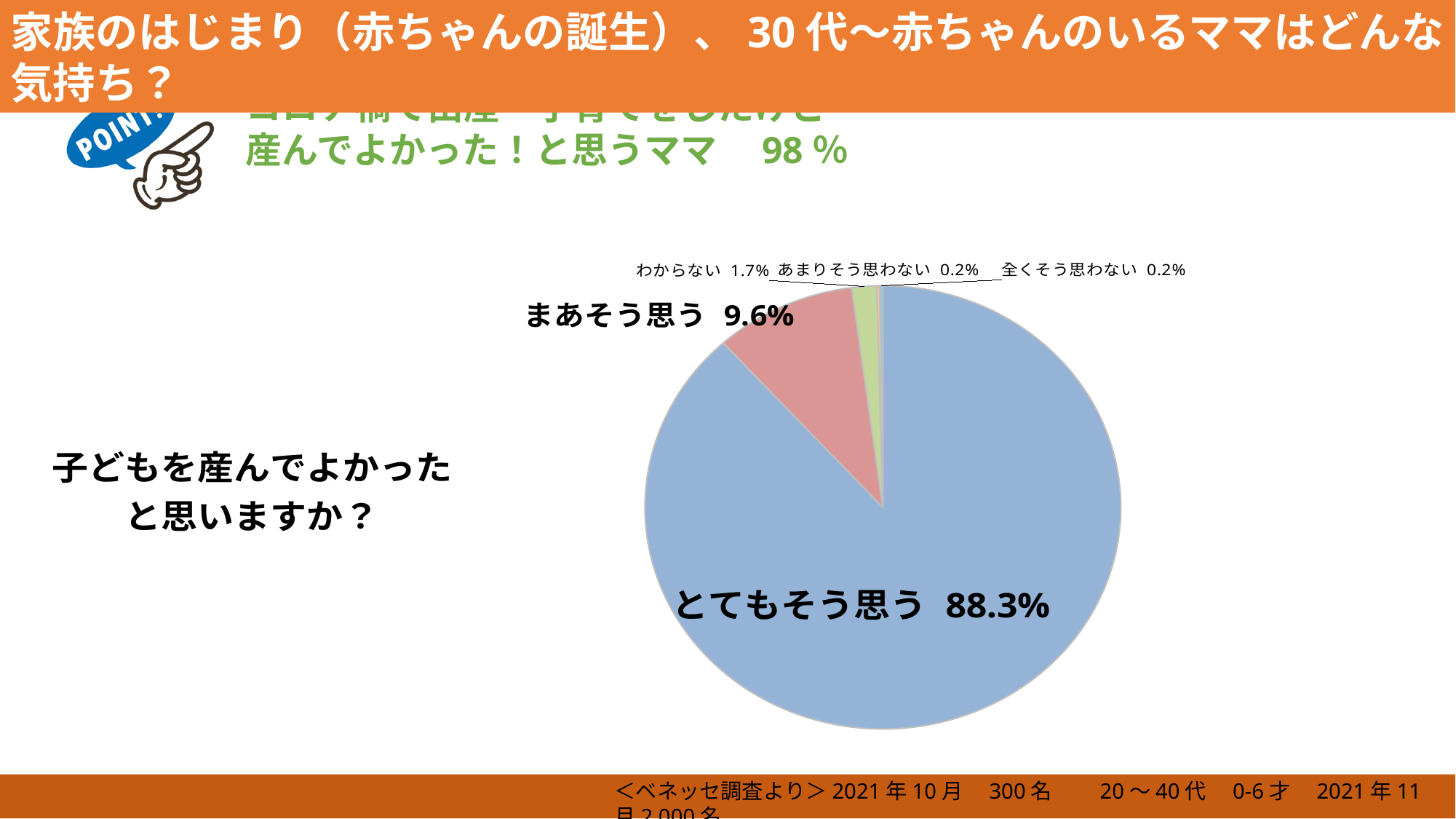
What is the combined share of とてもそう思う and まあそう思う? 97.9% Which is larger, the share for まあそう思う or the share for わからない? まあそう思う What type of chart is shown on the slide? Pie chart How many percentage points larger is とてもそう思う than まあそう思う? 78.7 What percentage of respondents answered まあそう思う? 9.6% What percentage is shown for 全くそう思わない? 0.2% How many response categories are shown in the pie chart? 5 What percentage is shown for あまりそう思わない? 0.2% What is the share shown for わからない? 1.7% Which response has the largest slice of the pie chart? とてもそう思う What percentage of respondents answered とてもそう思う in the pie chart? 88.3% What colour is the slice for とてもそう思う? Blue